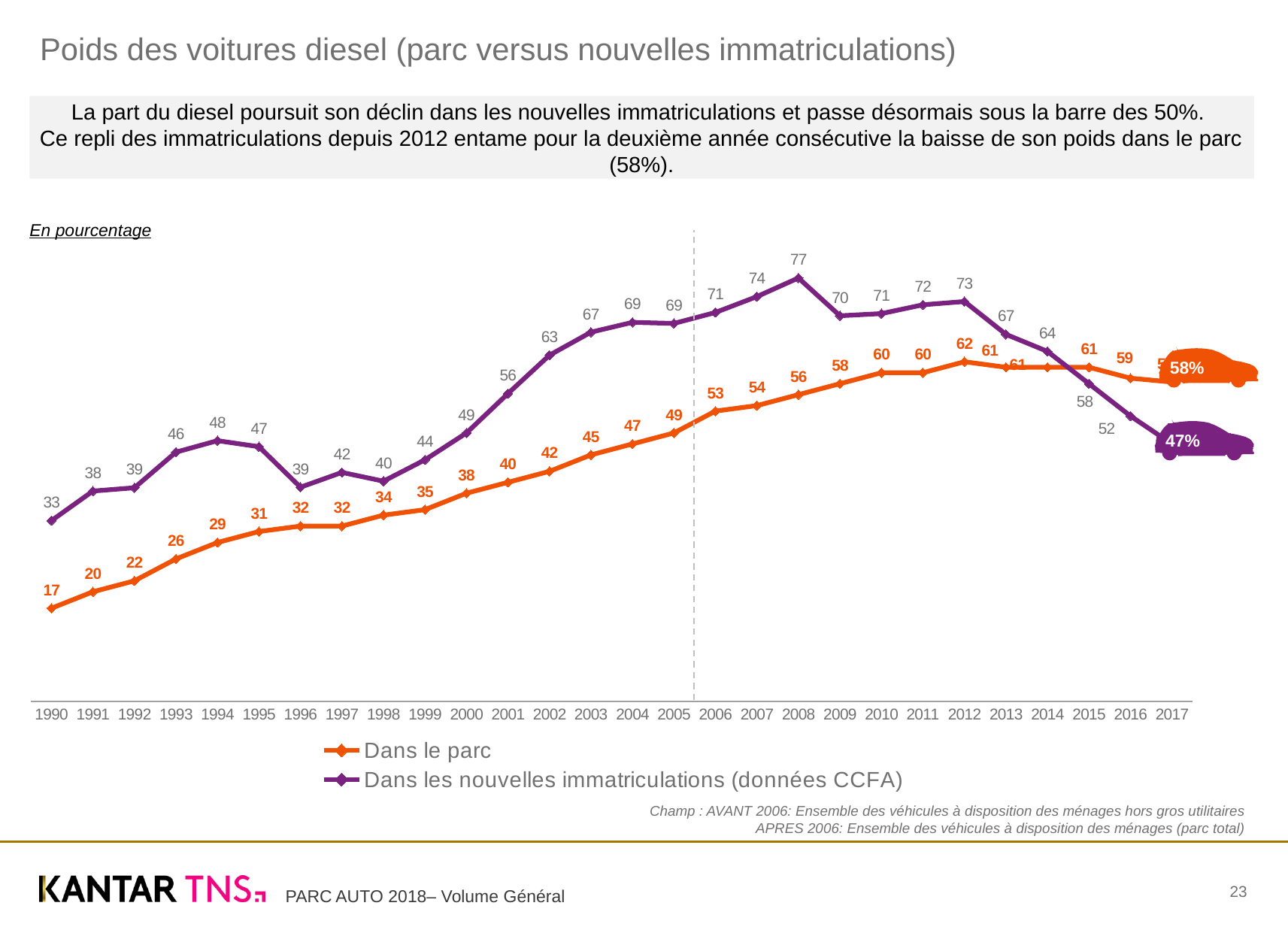
What is the value for 'Dans le parc' in 1990? 17 In which year is the 'Dans le parc' series at its lowest value? 1990 What is the value for 'Dans les nouvelles immatriculations (données CCFA)' in 2008? 77 In which year does the 'Dans les nouvelles immatriculations (données CCFA)' series reach its highest value? 2008 How many years are shown on the x axis? 28 What is the value for 'Dans les nouvelles immatriculations (données CCFA)' in 2017? 47% Does the 'Dans les nouvelles immatriculations (données CCFA)' series rise or fall from 2012 to 2017? fall How many series does the legend list? 2 What is the difference between the 'Dans les nouvelles immatriculations (données CCFA)' value and the 'Dans le parc' value in 2008? 21 What is the value for 'Dans le parc' in 2017? 58% What type of chart is shown on the slide? line chart In 2016, which series has the larger value: 'Dans le parc' or 'Dans les nouvelles immatriculations (données CCFA)'? Dans le parc